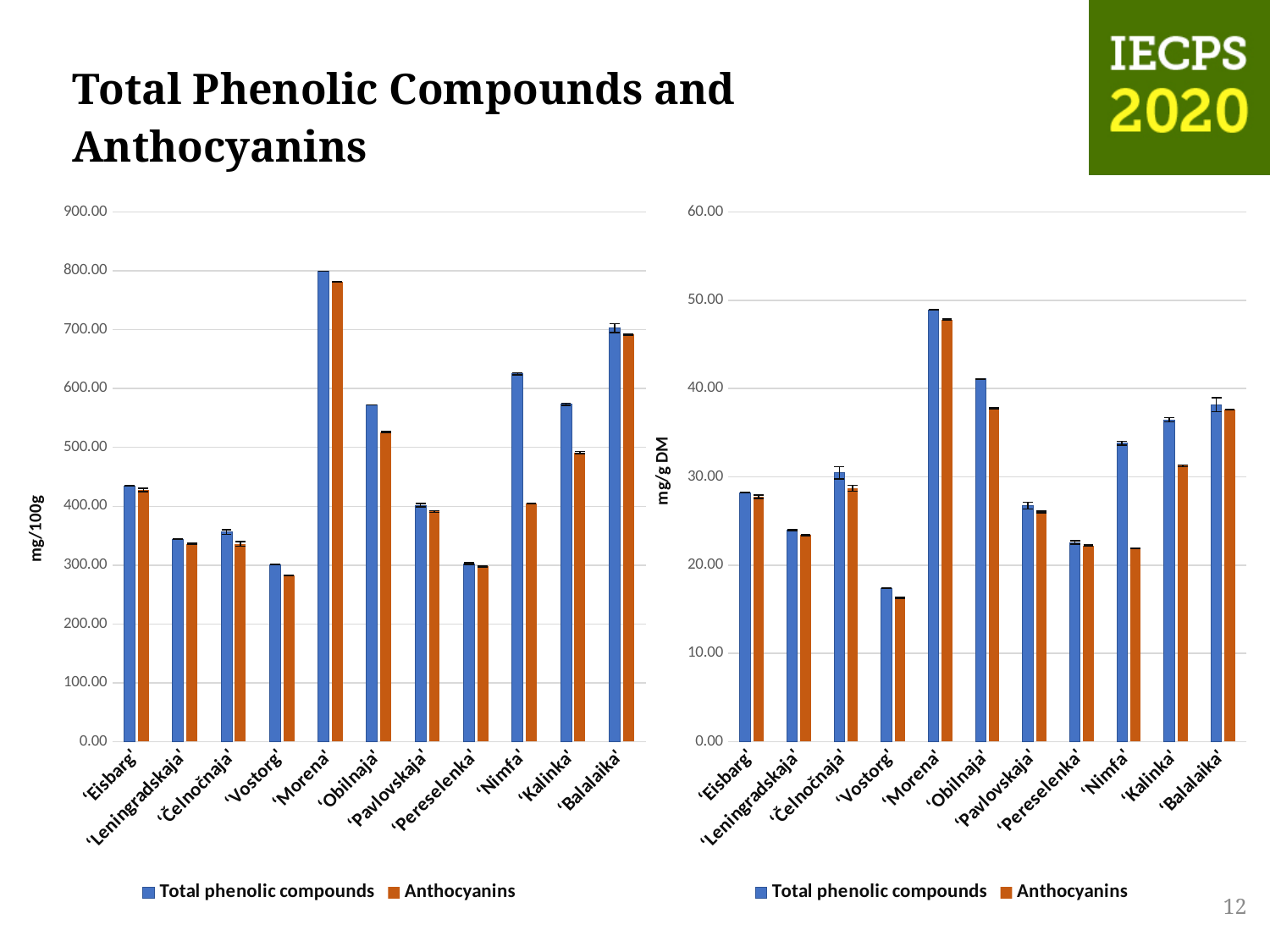
In the left chart (mg/100g), which cultivar has the highest Total phenolic compounds value? 'Morena' In the right chart (mg/g DM), which cultivar has the lowest Total phenolic compounds value? 'Vostorg' How many cultivars are shown on the x axis of the right chart (mg/g DM)? 11 In the left chart (mg/100g), which is larger for 'Nimfa': Total phenolic compounds or Anthocyanins? Total phenolic compounds In the right chart (mg/g DM), which cultivar has the highest Anthocyanins value? 'Morena' In the right chart (mg/g DM), is the Total phenolic compounds value for 'Vostorg' greater or less than 20.00? less In the left chart (mg/100g), is the Anthocyanins value for 'Nimfa' greater or less than 500.00? less How many series does the legend of the left chart (mg/100g) list? 2 In the left chart (mg/100g), is the Total phenolic compounds value for 'Morena' greater or less than 700.00? greater What kind of chart is the left chart (mg/100g)? Bar chart In the right chart (mg/g DM), which cultivar has the larger Total phenolic compounds value: 'Obilnaja' or 'Kalinka'? 'Obilnaja' What is the y-axis label of the right chart? mg/g DM